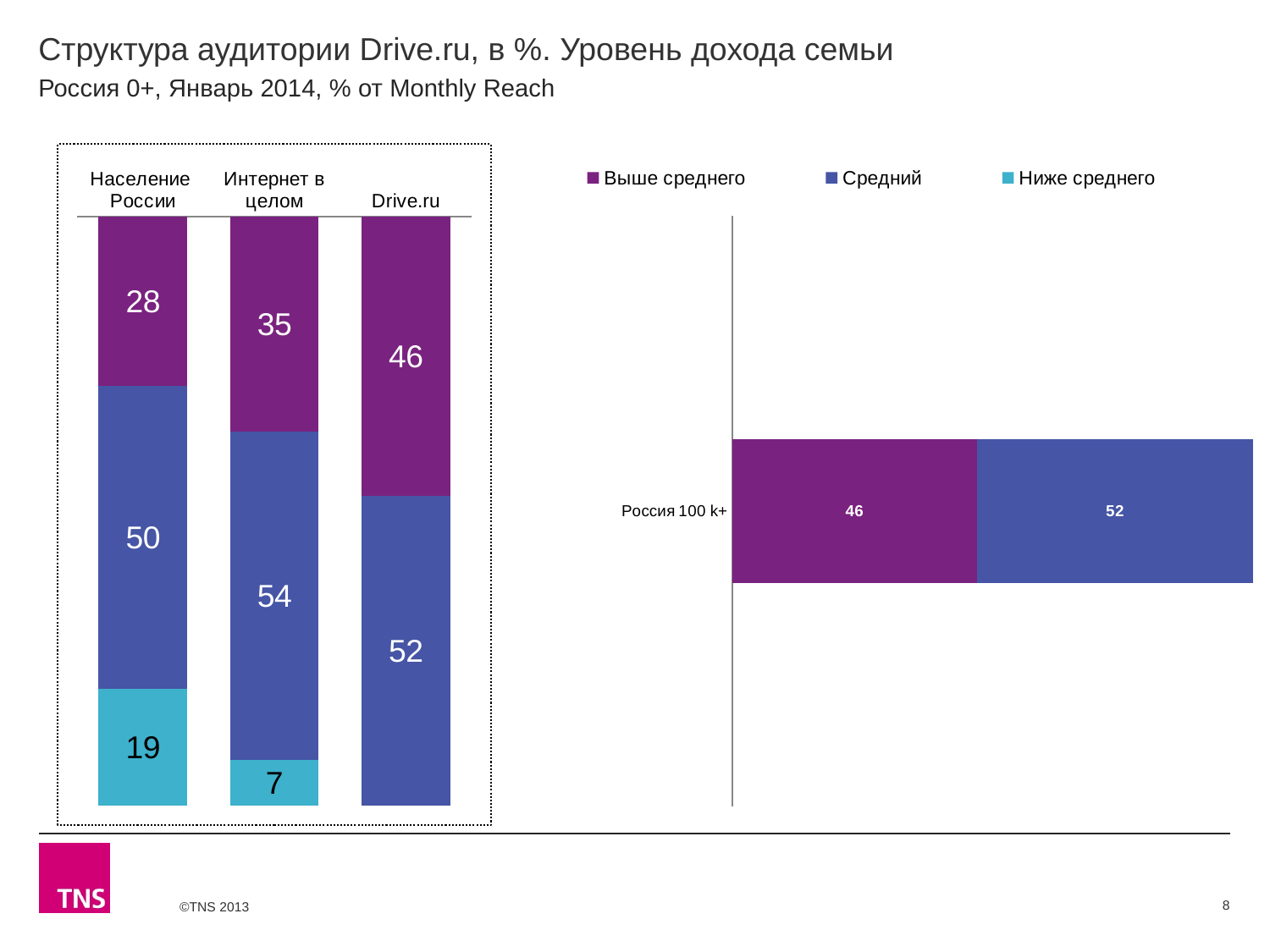
In the left chart, which category has the lowest 'Ниже среднего' value among those with a labelled segment? Интернет в целом In the left chart, which category has the highest 'Выше среднего' value? Drive.ru In the right chart, what is the value of the 'Средний' segment for 'Россия 100 k+'? 52 In the left chart, what is the value of the 'Средний' segment for 'Интернет в целом'? 54 How many series does the legend on the slide list? 3 In the left chart, what is the difference between the 'Выше среднего' values for Drive.ru and 'Население России'? 18 In the left chart, what is the value of the 'Выше среднего' segment for Drive.ru? 46 In the right chart, what is the total of the two labelled segments for 'Россия 100 k+'? 98 How many categories are shown on the x axis of the left chart? 3 In the left chart, which is larger: the 'Средний' value for 'Население России' or for 'Интернет в целом'? Интернет в целом In the left chart, what is the value of the 'Ниже среднего' segment for 'Население России'? 19 What type of chart is the chart on the right of the slide? Bar chart